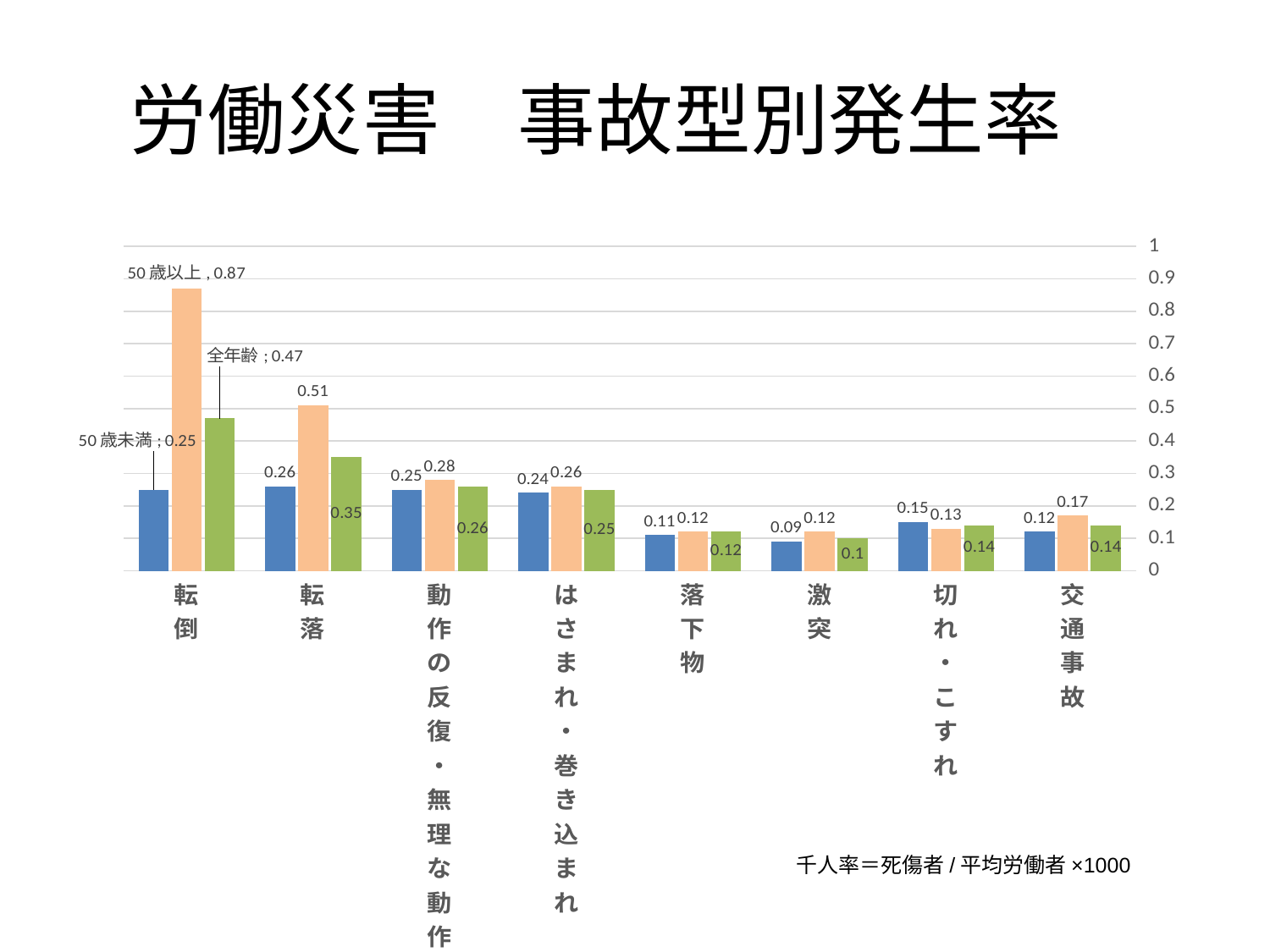
Which is larger in the 切れ・こすれ category, the 50歳未満 value or the 50歳以上 value? 50歳未満 Which category has the lowest value for 50歳未満? 激突 Which category has the highest value for 50歳以上? 転倒 What kind of chart is shown on the slide? Bar chart What is the value for 50歳以上 in the 交通事故 category? 0.17 How many data series are plotted for each category? 3 What is the value for 50歳以上 in the 転倒 category? 0.87 How many accident-type categories are shown on the x axis? 8 Is the value for 50歳以上 in the 転落 category greater or less than 0.4? greater What is the difference between the 50歳以上 and 50歳未満 values in the 転倒 category? 0.62 What is the value for 50歳未満 in the 激突 category? 0.09 What is the value for 全年齢 in the 転落 category? 0.35